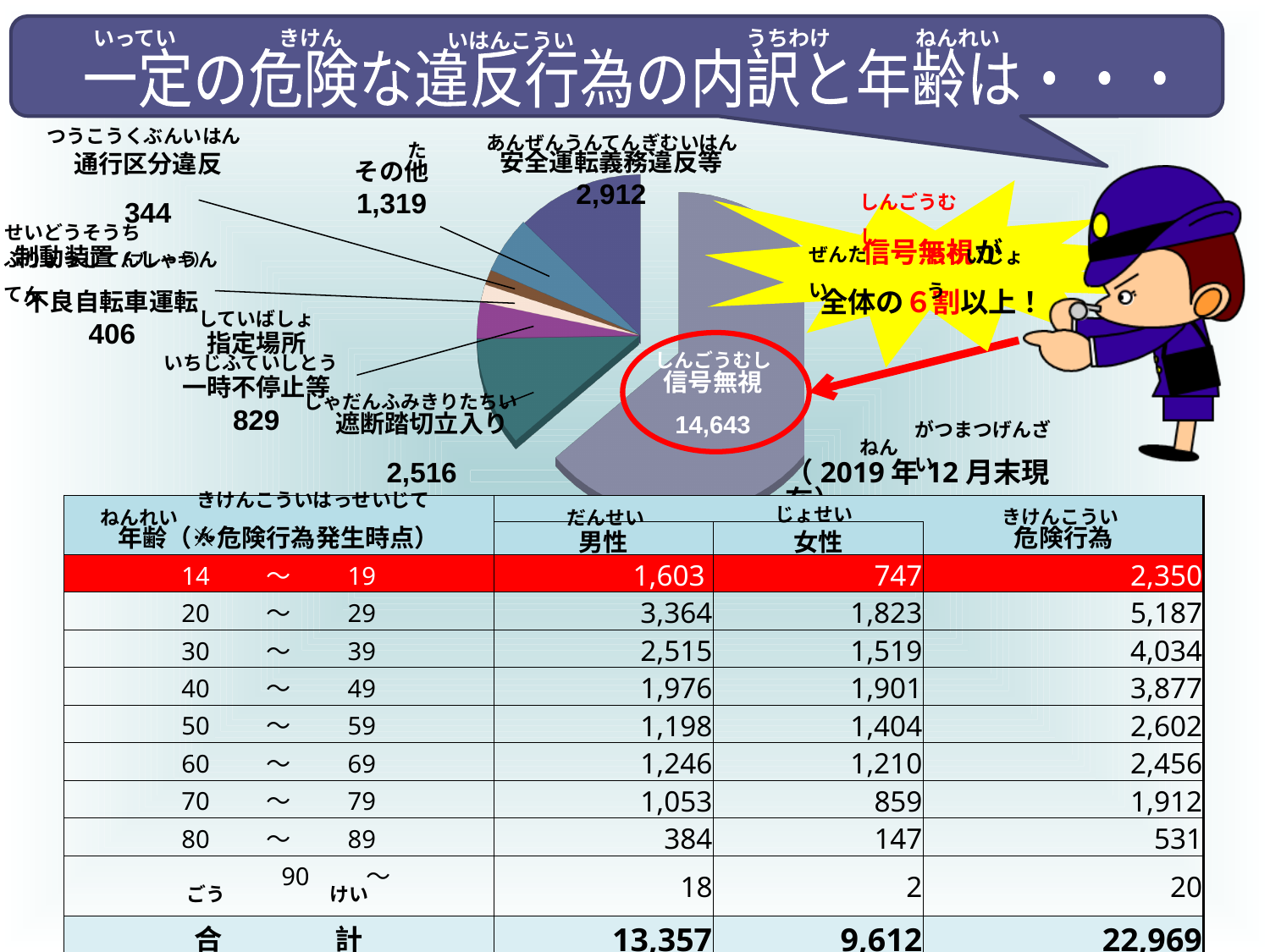
What is the value for その他 in the pie chart? 1,319 According to the callout on the slide, what share of the total does 信号無視 account for? 6割以上 How many categories does the pie chart show? 7 Which category has the largest slice in the pie chart? 信号無視 What is the value for 通行区分違反 in the pie chart? 344 What is the value for 遮断踏切立入り in the pie chart? 2,516 What is the value for 信号無視 in the pie chart? 14,643 What kind of chart is shown on the slide? pie chart What is the value for 安全運転義務違反等 in the pie chart? 2,912 Which category has the smallest slice in the pie chart? 通行区分違反 What is the difference between 安全運転義務違反等 and 遮断踏切立入り in the pie chart? 396 Which is larger in the pie chart, その他 or 指定場所一時不停止等? その他